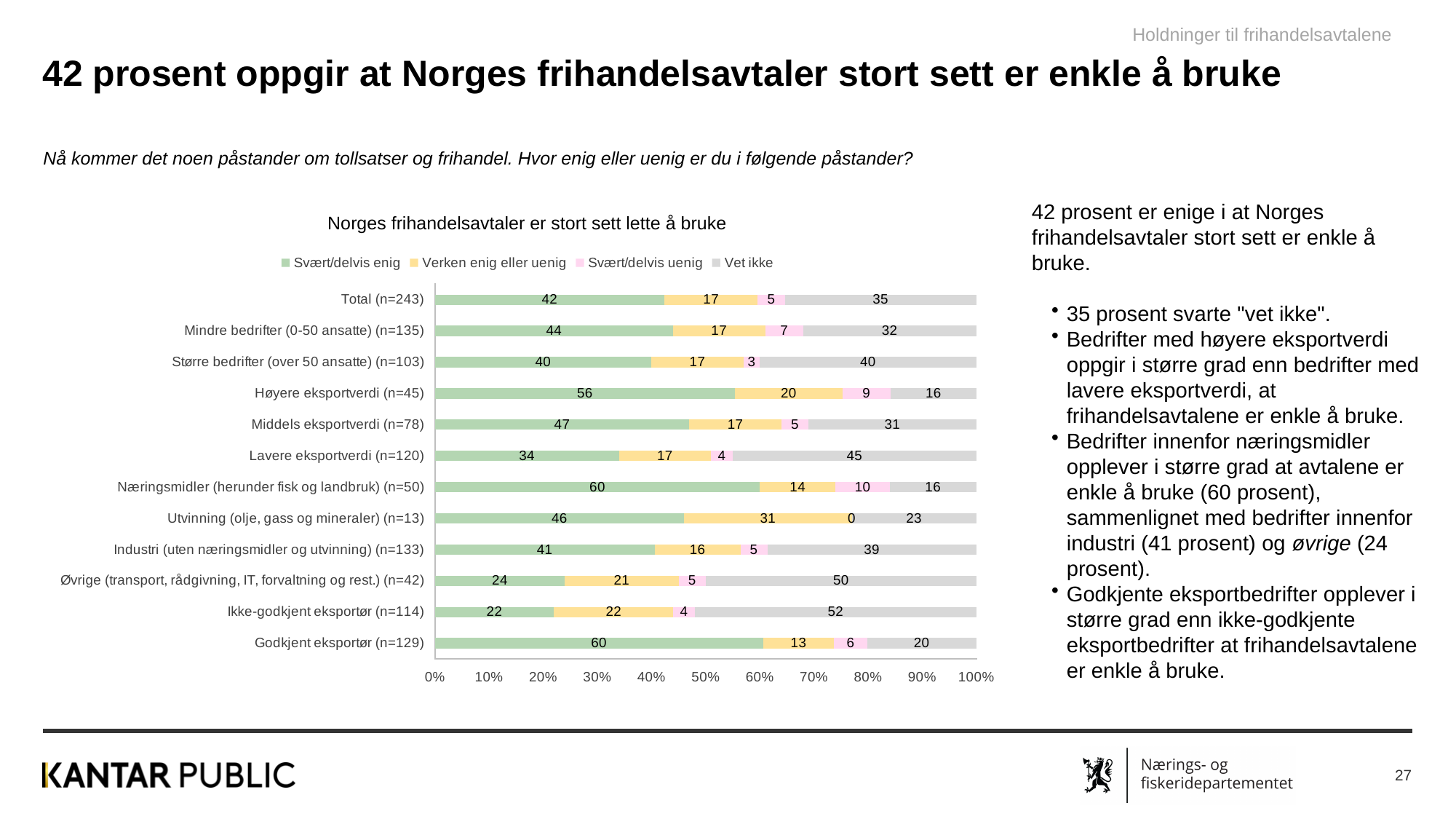
Which category has the lowest 'Svært/delvis enig' value? Ikke-godkjent eksportør (n=114) How many series does the legend list? 4 How many categories (rows) are plotted in the chart? 12 Which has a larger 'Svært/delvis enig' value: Mindre bedrifter (0-50 ansatte) (n=135) or Større bedrifter (over 50 ansatte) (n=103)? Mindre bedrifter (0-50 ansatte) (n=135) What is the title of the chart? Norges frihandelsavtaler er stort sett lette å bruke What is the 'Vet ikke' value for Lavere eksportverdi (n=120)? 45 What is the difference between the 'Svært/delvis enig' values for Høyere eksportverdi (n=45) and Lavere eksportverdi (n=120)? 22 What is the 'Svært/delvis enig' value for Total (n=243)? 42 Which category has the highest 'Verken enig eller uenig' value? Utvinning (olje, gass og mineraler) (n=13) What type of chart is shown on the slide? Stacked bar chart Which category has the highest 'Vet ikke' value? Ikke-godkjent eksportør (n=114) What is the 'Verken enig eller uenig' value for Utvinning (olje, gass og mineraler) (n=13)? 31